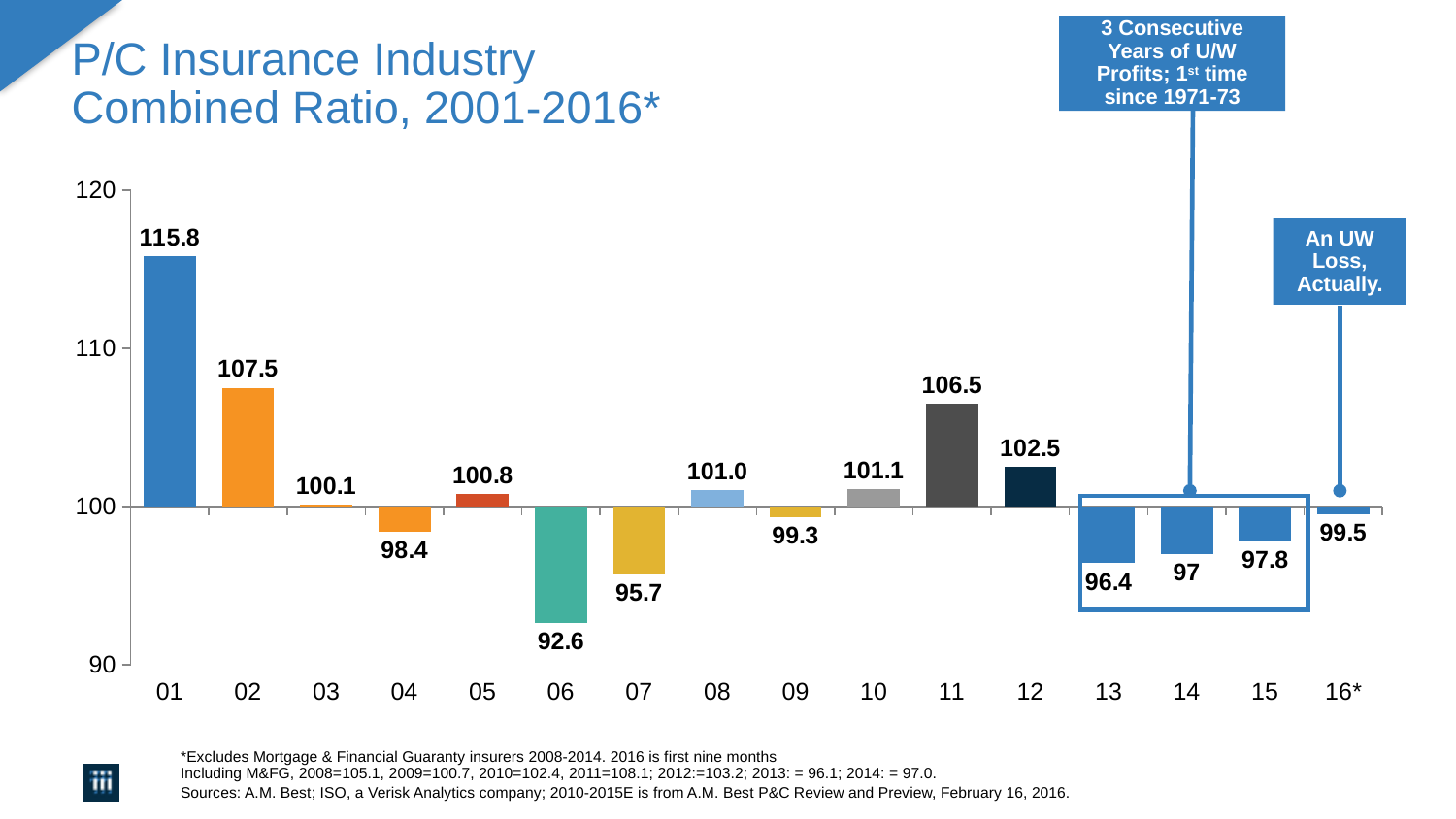
How many years are shown on the x axis? 16 What is the combined ratio for 06? 92.6 What is the combined ratio for 14? 97 What kind of chart is shown on the slide? Bar chart What is the combined ratio for 01? 115.8 What is the difference between the combined ratio for 11 and for 12? 4.0 Which year has the larger combined ratio, 11 or 12? 11 Is the value for 01 greater or less than 110? greater Which year has the lowest combined ratio? 06 What is the difference between the combined ratio for 01 and for 02? 8.3 What is the combined ratio for 16*? 99.5 Which year has the highest combined ratio? 01